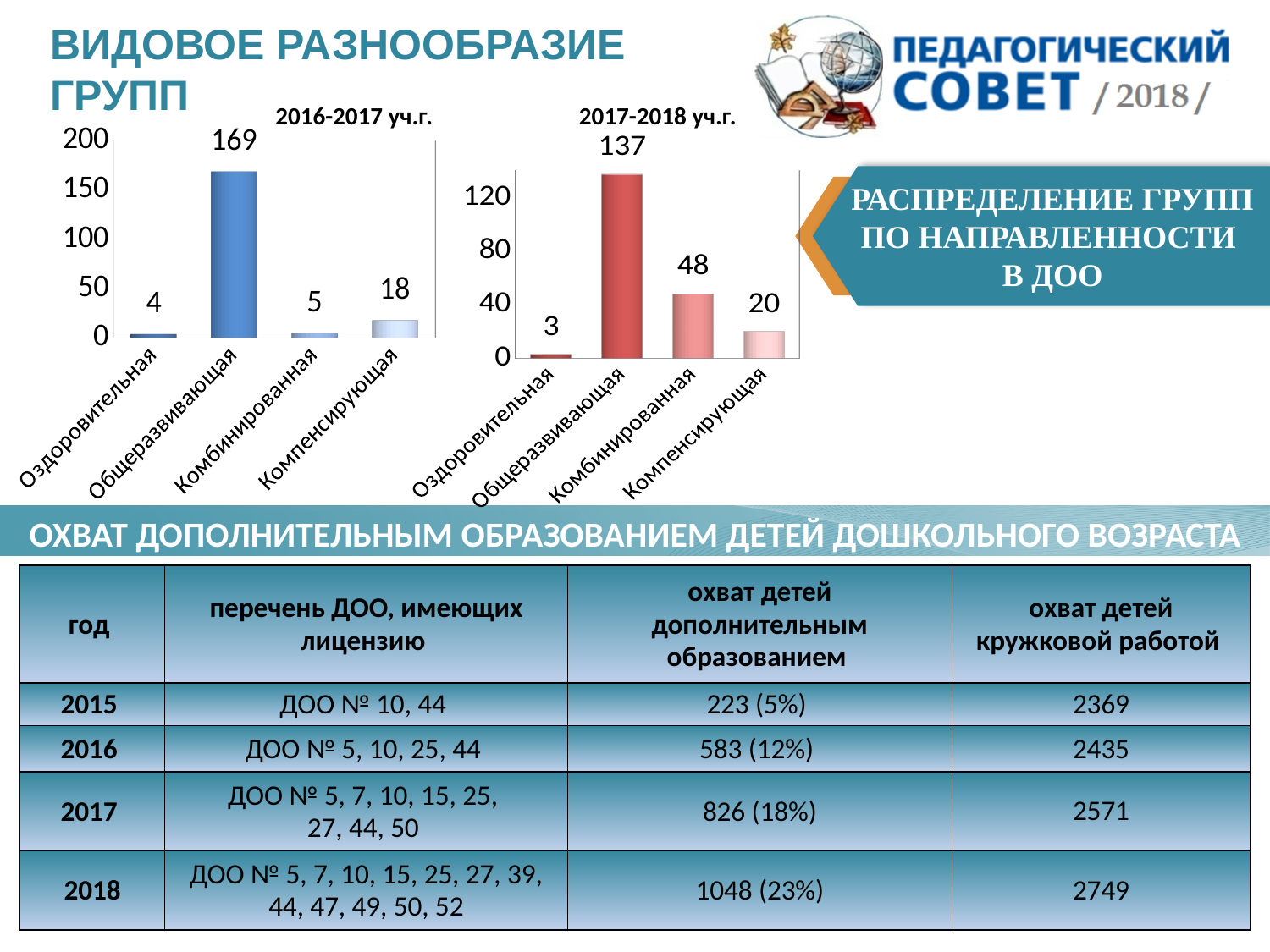
In the 2017-2018 уч.г. chart, which category has the lowest value? Оздоровительная How many categories are shown in the 2017-2018 уч.г. chart? 4 In the 2016-2017 уч.г. chart, what is the value for Общеразвивающая? 169 In the 2016-2017 уч.г. chart, what is the value for Компенсирующая? 18 In the 2017-2018 уч.г. chart, what is the value for Комбинированная? 48 In the 2016-2017 уч.г. chart, what is the difference between Компенсирующая and Оздоровительная? 14 In the 2016-2017 уч.г. chart, is the value for Общеразвивающая greater or less than 150? greater In the 2016-2017 уч.г. chart, which category has the highest value? Общеразвивающая What kind of chart is the 2016-2017 уч.г. chart? bar chart What colour are the bars in the 2017-2018 уч.г. chart? red In the 2017-2018 уч.г. chart, what is the difference between Общеразвивающая and Комбинированная? 89 In the 2017-2018 уч.г. chart, which is larger: Комбинированная or Компенсирующая? Комбинированная